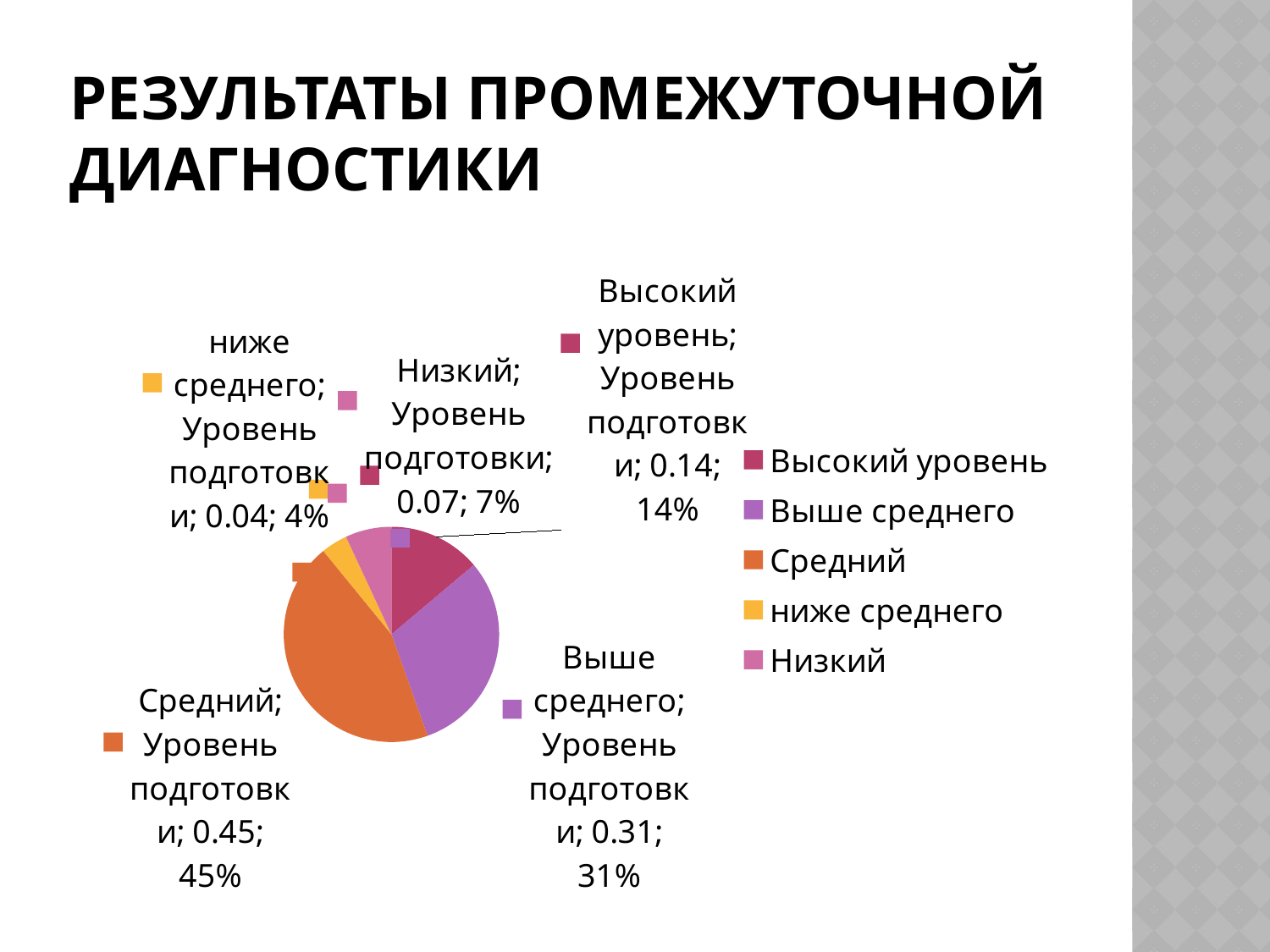
What percentage is shown for "Высокий уровень" in the pie chart? 14% What kind of chart is shown on the slide? pie chart What percentage share does the "Средний" slice have in the pie chart? 45% How many categories does the pie chart have? 5 What percentage is shown for "Низкий" in the pie chart? 7% What value is shown for "ниже среднего" in the pie chart? 0.04 What value is shown for "Выше среднего" in the pie chart? 0.31 What is the title of the slide containing the pie chart? Результаты промежуточной диагностики Which category has the smallest slice in the pie chart? ниже среднего Which category has the largest slice in the pie chart? Средний What is the difference in percentage points between the "Средний" and "Выше среднего" slices? 14 Which slice is larger: "Высокий уровень" or "Низкий"? Высокий уровень